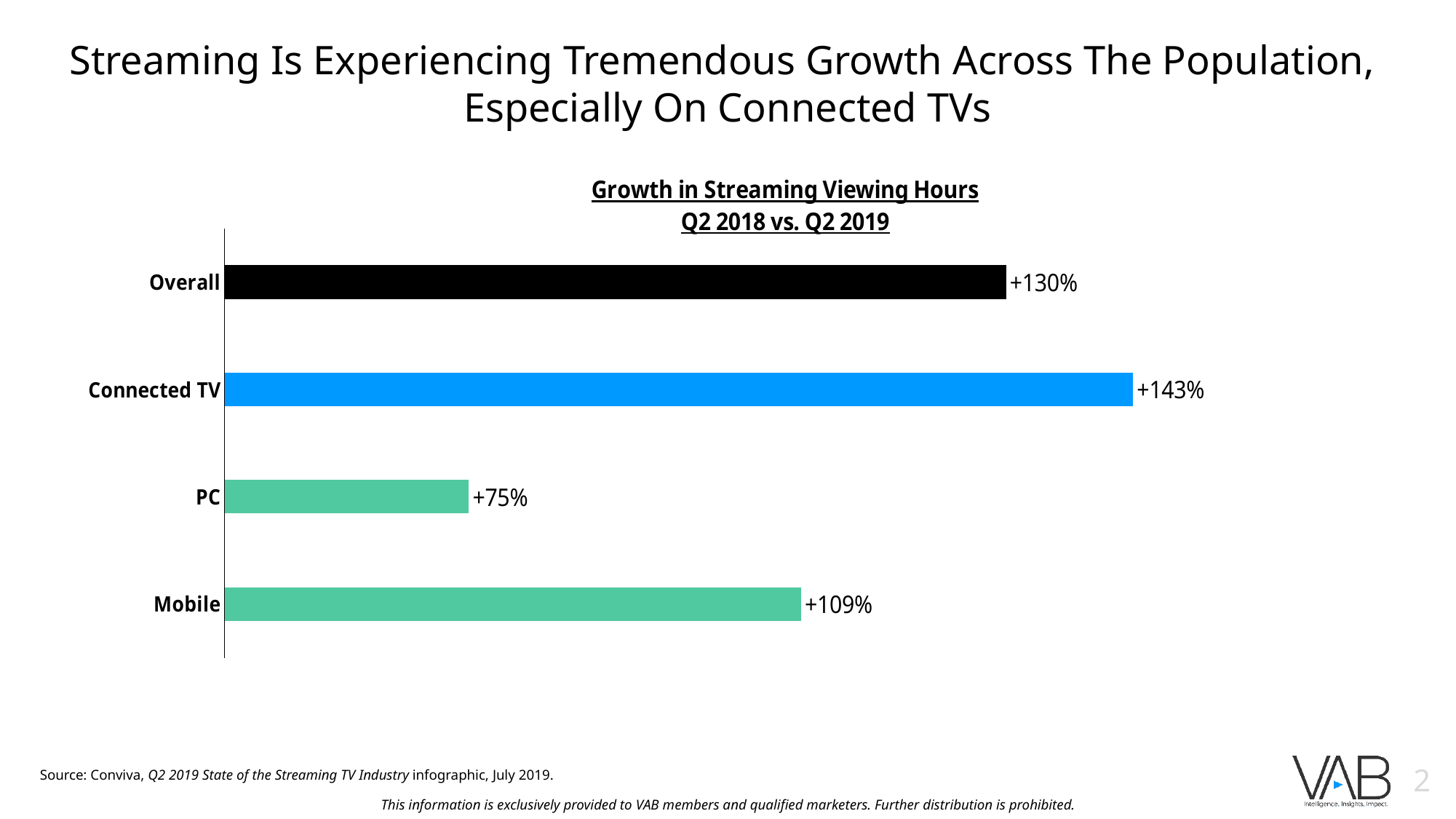
What is the difference in growth between Connected TV and PC? 68 percentage points Which category shows the highest growth in streaming viewing hours? Connected TV What is the growth in streaming viewing hours for Mobile? +109% What type of chart is shown on the slide? Bar chart What is the growth in streaming viewing hours for Connected TV? +143% What is the growth in streaming viewing hours for PC? +75% How many categories are shown in the chart? 4 What is the difference in growth between Overall and Mobile? 21 percentage points Which category shows the lowest growth in streaming viewing hours? PC What is the title of the chart? Growth in Streaming Viewing Hours Q2 2018 vs. Q2 2019 What is the Overall growth in streaming viewing hours? +130% Which has higher growth in streaming viewing hours, Mobile or PC? Mobile